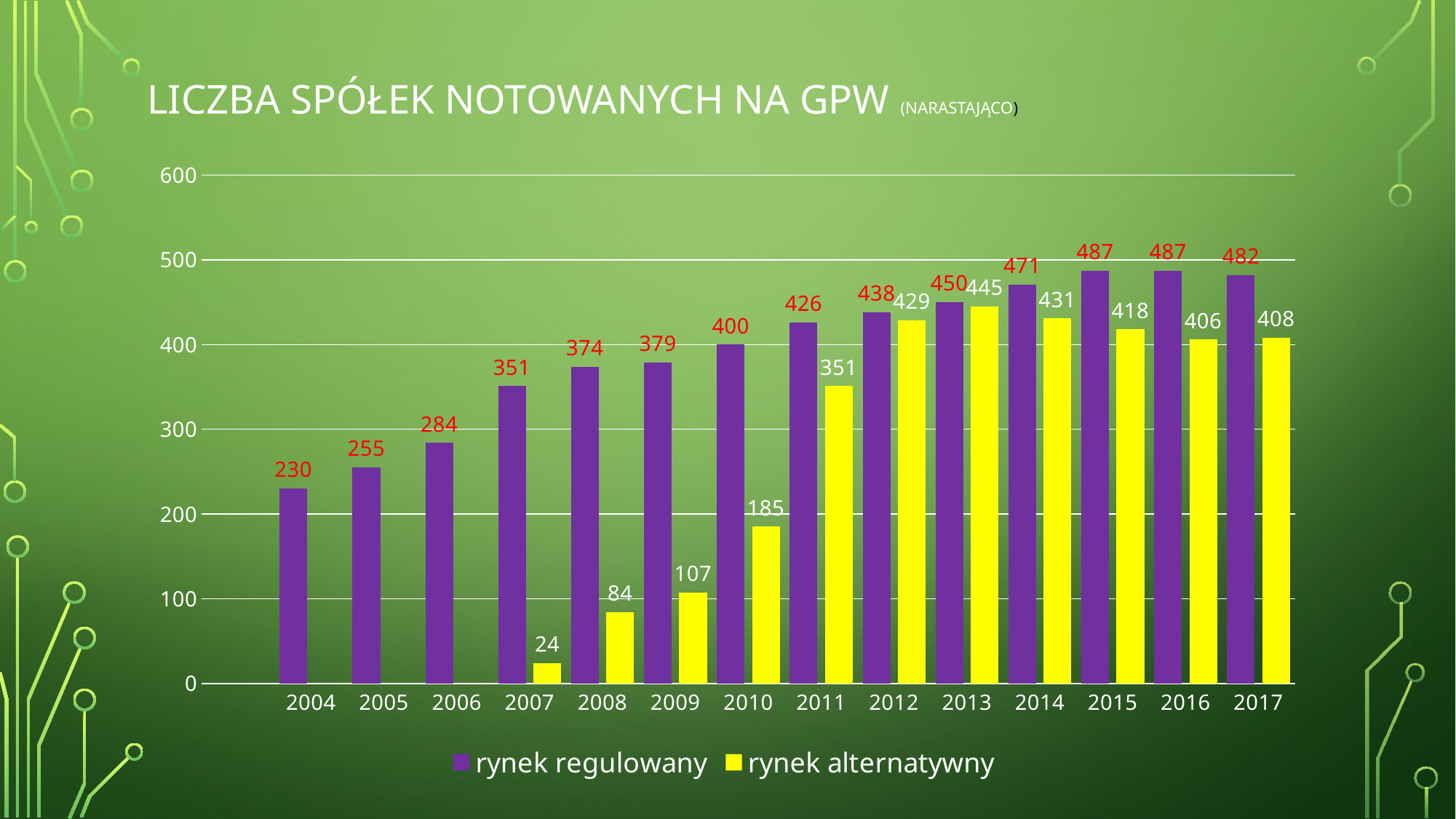
How many series does the legend list? 2 What kind of chart is shown on the slide? bar chart What is the value for rynek alternatywny in 2013? 445 How many years are shown on the x axis? 14 Which is larger in 2011: rynek regulowany or rynek alternatywny? rynek regulowany Does the value for rynek alternatywny rise or fall from 2007 to 2013? rise Which year has the lowest value for rynek regulowany? 2004 What is the value for rynek regulowany in 2010? 400 What is the difference between rynek regulowany and rynek alternatywny in 2017? 74 Which year has the highest value for rynek alternatywny? 2013 What is the value for rynek alternatywny in 2007? 24 What colour are the bars for rynek alternatywny? yellow